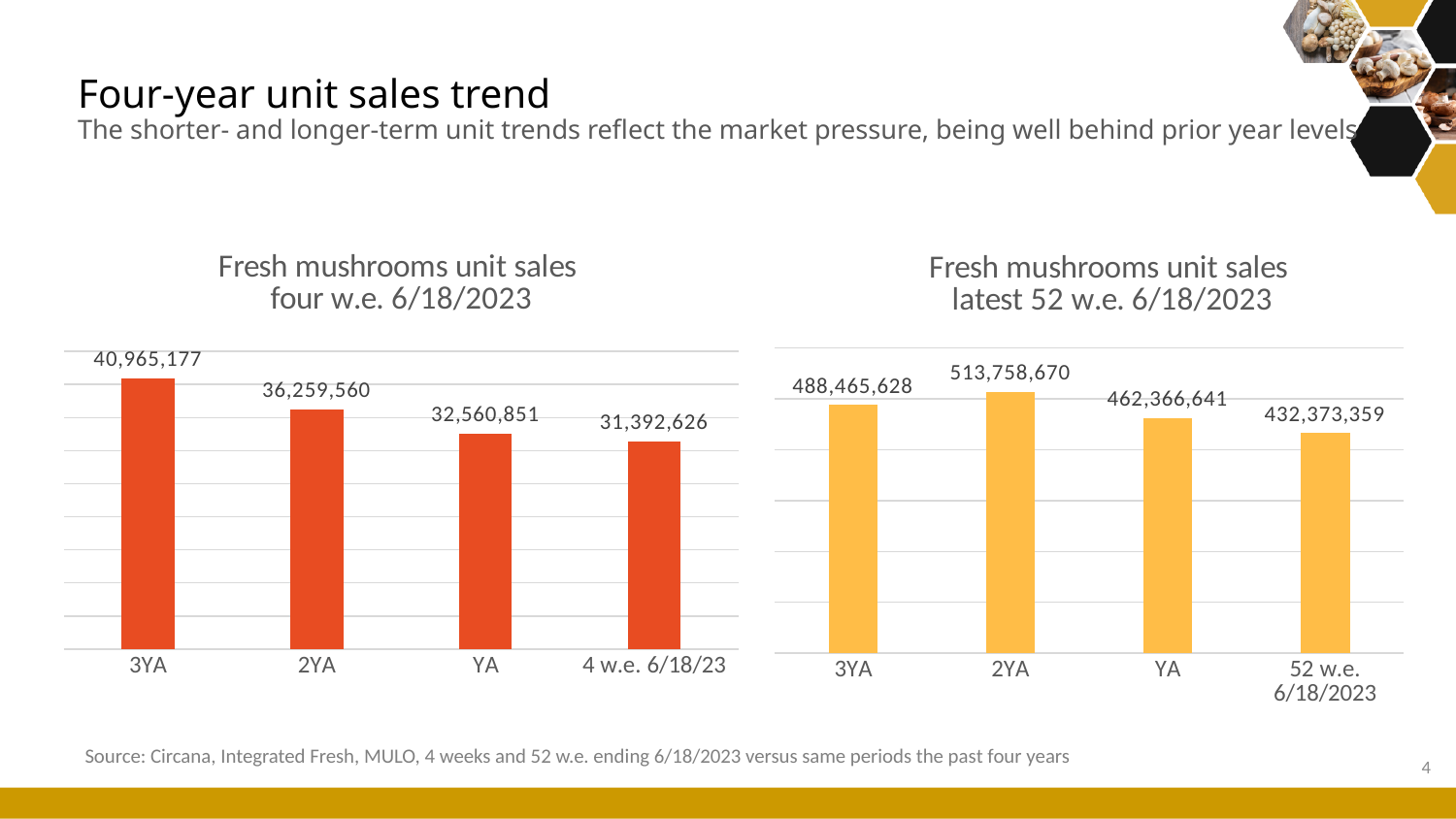
In the 'Fresh mushrooms unit sales latest 52 w.e. 6/18/2023' chart, what is the difference between the 2YA value and the 52 w.e. 6/18/2023 value? 81,385,311 In the 'Fresh mushrooms unit sales latest 52 w.e. 6/18/2023' chart, what is the value for YA? 462,366,641 In the 'Fresh mushrooms unit sales latest 52 w.e. 6/18/2023' chart, which category has the highest value? 2YA What type of chart is the 'Fresh mushrooms unit sales four w.e. 6/18/2023' chart? Bar chart How many bars are in the 'Fresh mushrooms unit sales four w.e. 6/18/2023' chart? 4 In the 'Fresh mushrooms unit sales four w.e. 6/18/2023' chart, what is the value for 3YA? 40,965,177 In the 'Fresh mushrooms unit sales four w.e. 6/18/2023' chart, what is the difference between the 3YA value and the 4 w.e. 6/18/23 value? 9,572,551 In the 'Fresh mushrooms unit sales four w.e. 6/18/2023' chart, which category has the lowest value? 4 w.e. 6/18/23 In the 'Fresh mushrooms unit sales four w.e. 6/18/2023' chart, do the values rise or fall from 3YA to 4 w.e. 6/18/23? Fall In the 'Fresh mushrooms unit sales latest 52 w.e. 6/18/2023' chart, which category has the lowest value? 52 w.e. 6/18/2023 In the 'Fresh mushrooms unit sales four w.e. 6/18/2023' chart, what is the value for 4 w.e. 6/18/23? 31,392,626 In the 'Fresh mushrooms unit sales latest 52 w.e. 6/18/2023' chart, which is larger, the value for 3YA or the value for 2YA? 2YA